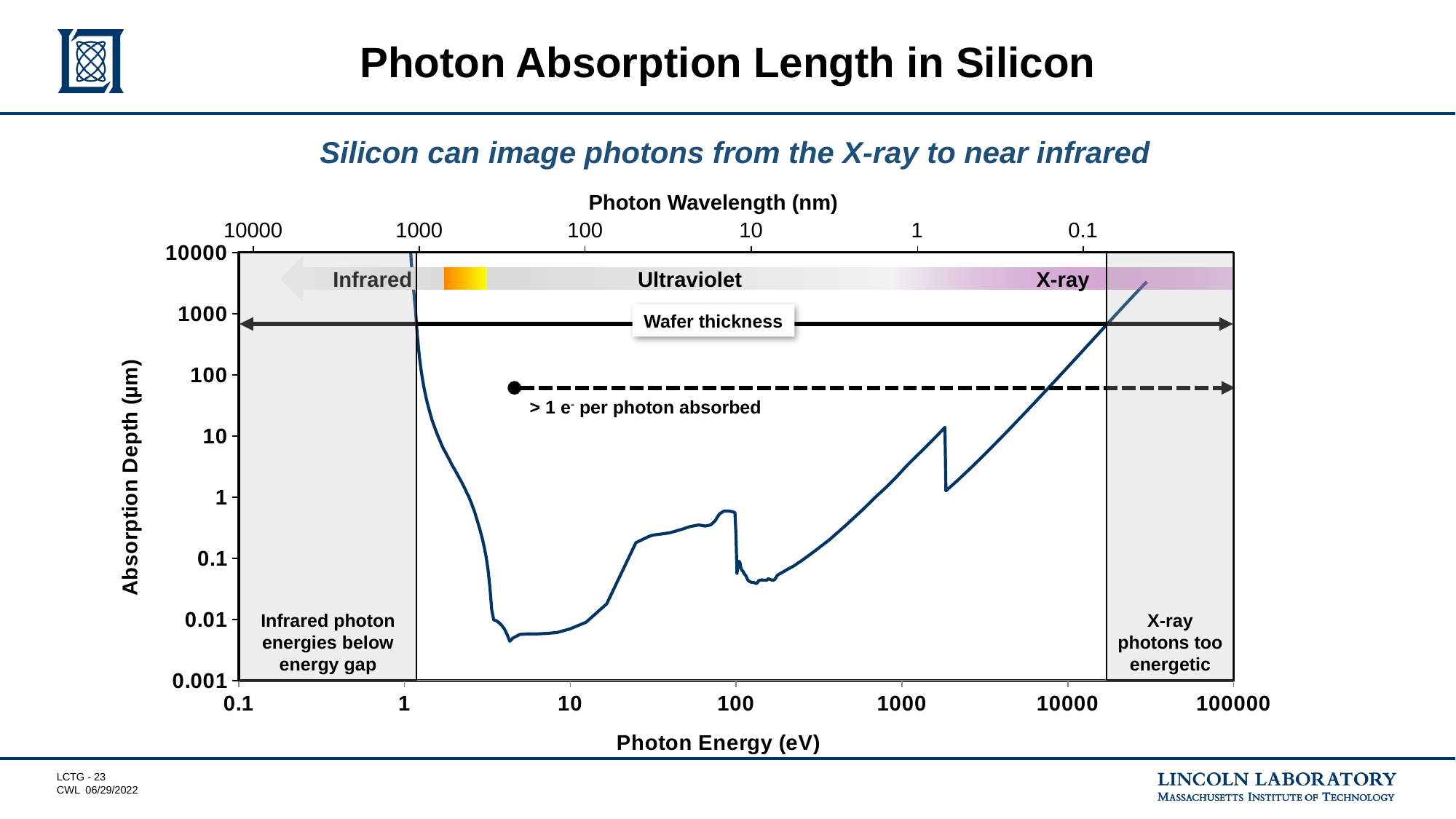
What is the title of the bottom x axis of the chart? Photon Energy (eV) Which has the larger absorption depth: a photon energy of 1 eV or 10 eV? 1 eV Between photon energies of 1 eV and 4 eV, does the absorption depth rise or fall as energy increases? fall Is the lowest absorption depth on the curve greater or less than 0.01 µm? less Between photon energies of 1000 eV and 10000 eV, does the absorption depth rise or fall as energy increases? rise What kind of chart is shown on the slide? line chart Which has the larger absorption depth: a photon energy of 100 eV or 10000 eV? 10000 eV Is the absorption depth at a photon energy of 100 eV greater or less than 10 µm? less What is the title of the y axis of the chart? Absorption Depth (µm) How many labeled tick marks are on the bottom x axis (Photon Energy) of the chart? 7 Is the absorption depth at a photon energy of 10000 eV greater or less than 10 µm? greater